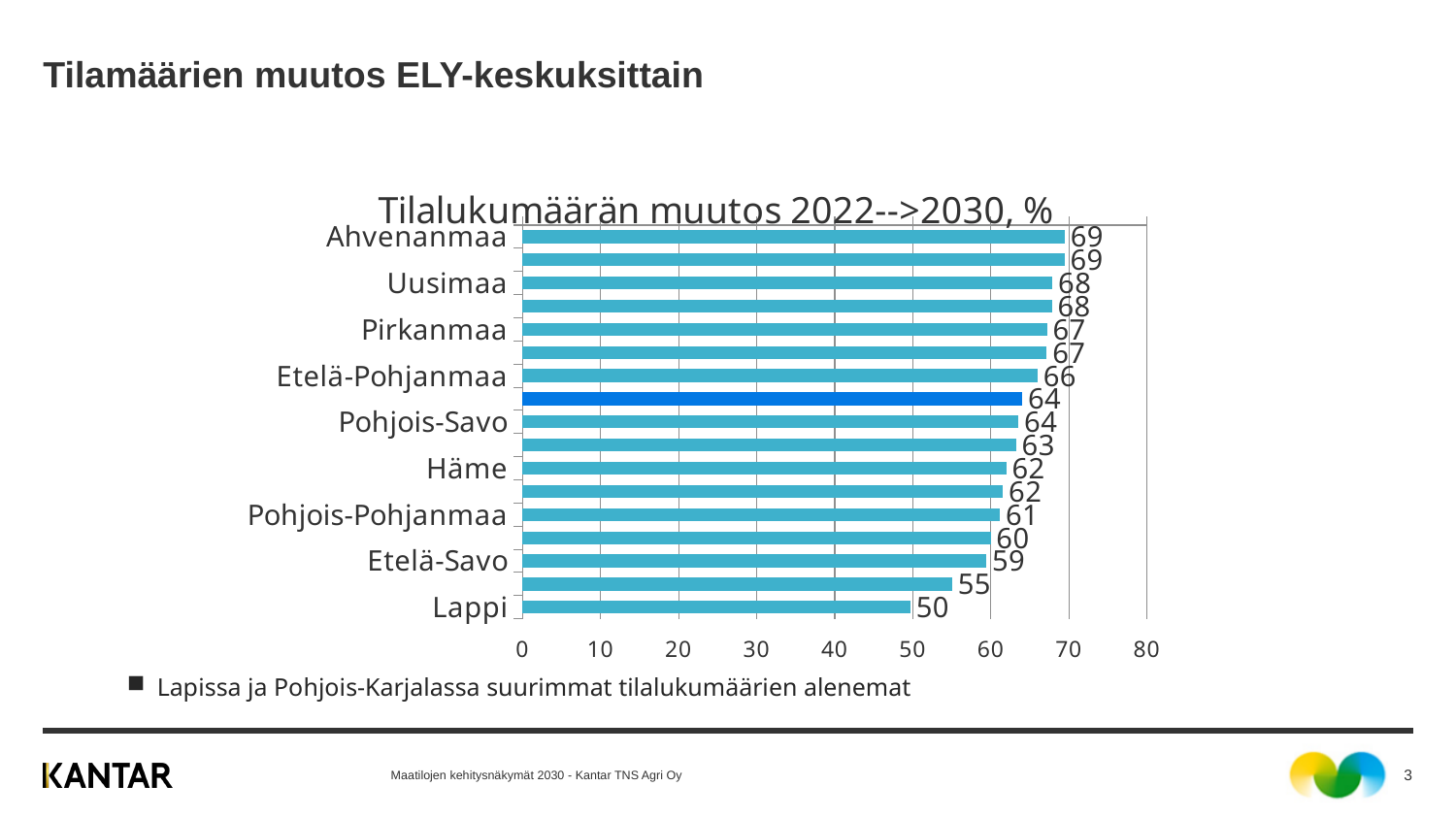
What is the value for Pohjois-Pohjanmaa? 61 What is the value for Etelä-Pohjanmaa? 66 How many bars are plotted in the chart? 17 What is the difference between the values for Ahvenanmaa and Lappi? 19 What is the value for Lappi? 50 Which labelled category has the lowest value? Lappi What is the value for Ahvenanmaa? 69 What is the title of the chart? Tilalukumäärän muutos 2022-->2030, % What is the value for Uusimaa? 68 What type of chart is shown on the slide? bar chart Which has a larger value, Pirkanmaa or Häme? Pirkanmaa Do the bar values increase or decrease going from the top of the chart to the bottom? decrease